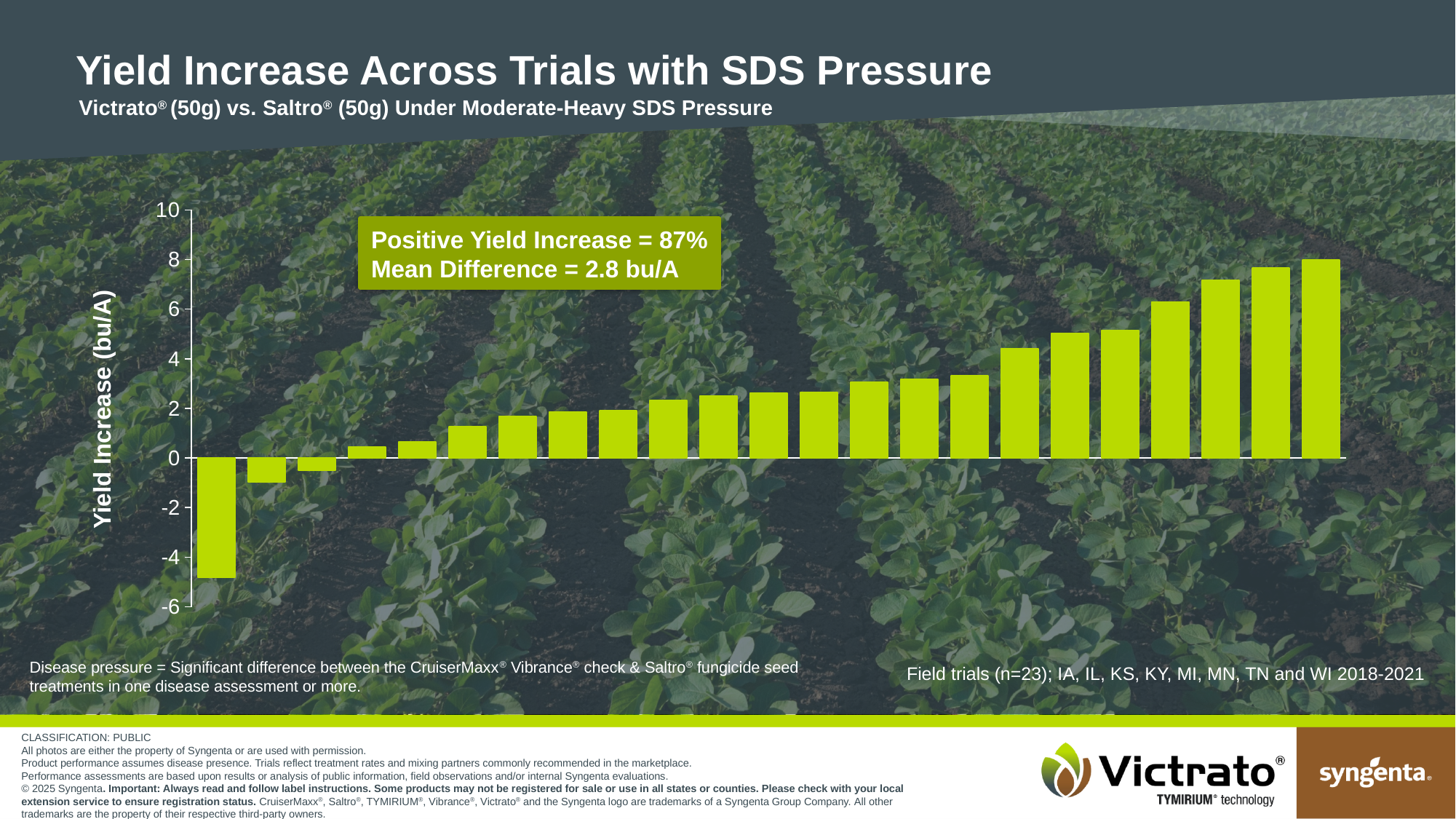
According to the text box on the chart, what is the mean difference in yield? 2.8 bu/A What kind of chart is shown on the slide? bar chart What is the highest value shown on the y axis of the chart? 10 How many bars (trials) are plotted in the chart? 23 Is the value of the tallest bar greater or less than 10? less Do the bar values rise or fall from left to right across the chart? rise How many bars in the chart have a negative value (fall below 0)? 3 Is the value of the leftmost bar greater or less than -4? less Which bar is larger, the leftmost bar or the rightmost bar? the rightmost bar Is the value of the rightmost bar greater or less than 6? greater What is the title of the y axis of the chart? Yield Increase (bu/A) According to the text box on the chart, what percentage of trials showed a positive yield increase? 87%